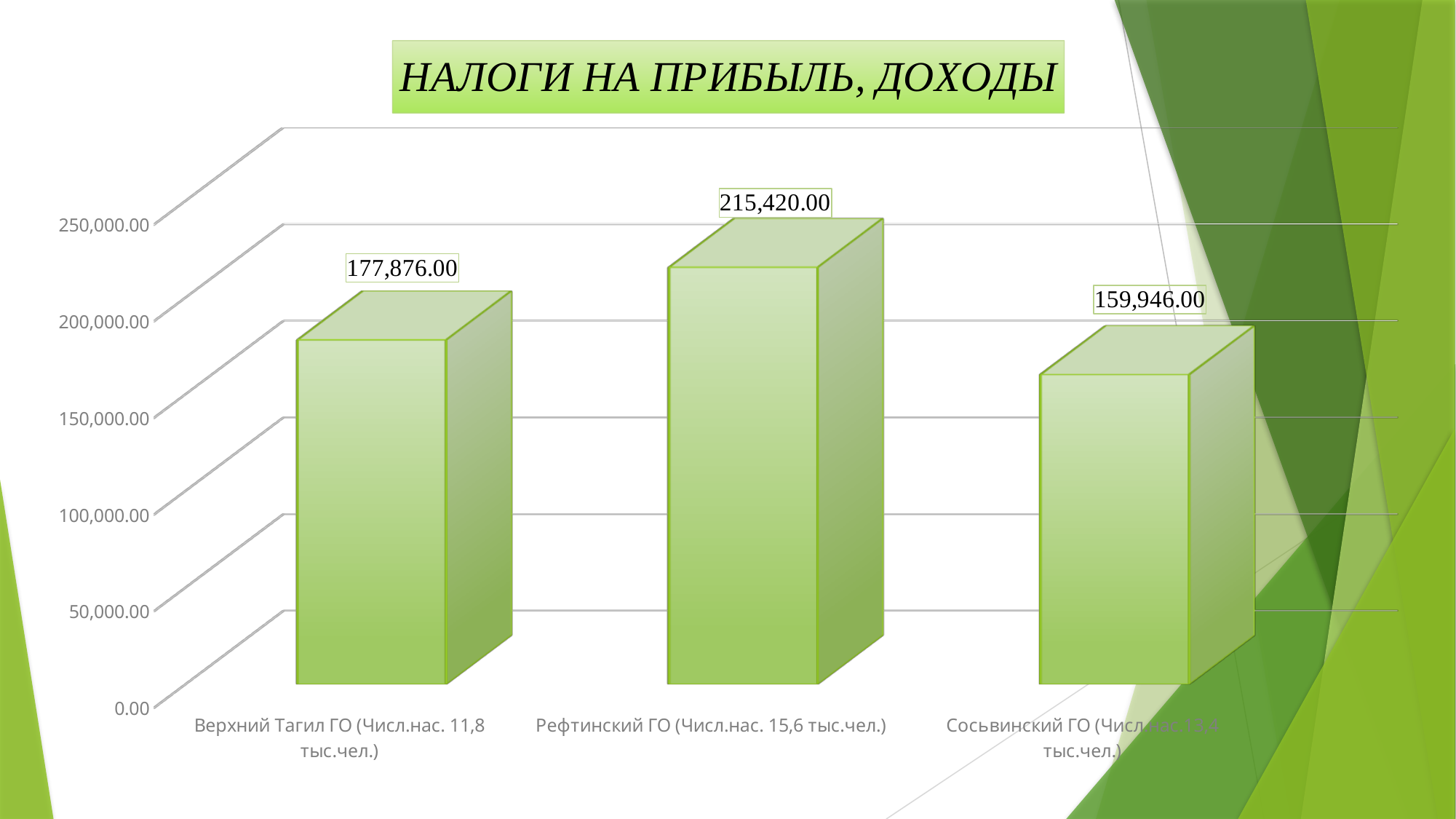
What is the title of the chart? НАЛОГИ НА ПРИБЫЛЬ, ДОХОДЫ What is the value for Сосьвинский ГО? 159,946.00 What is the value for Верхний Тагил ГО? 177,876.00 Which category has the highest value? Рефтинский ГО What kind of chart is shown on the slide? bar chart Is the value for Рефтинский ГО greater or less than 200,000.00? greater How many categories are shown in the chart? 3 Which is larger, the value for Верхний Тагил ГО or the value for Сосьвинский ГО? Верхний Тагил ГО What is the value for Рефтинский ГО? 215,420.00 Which category has the lowest value? Сосьвинский ГО What is the difference between the values for Верхний Тагил ГО and Сосьвинский ГО? 17,930.00 What is the difference between the values for Рефтинский ГО and Верхний Тагил ГО? 37,544.00